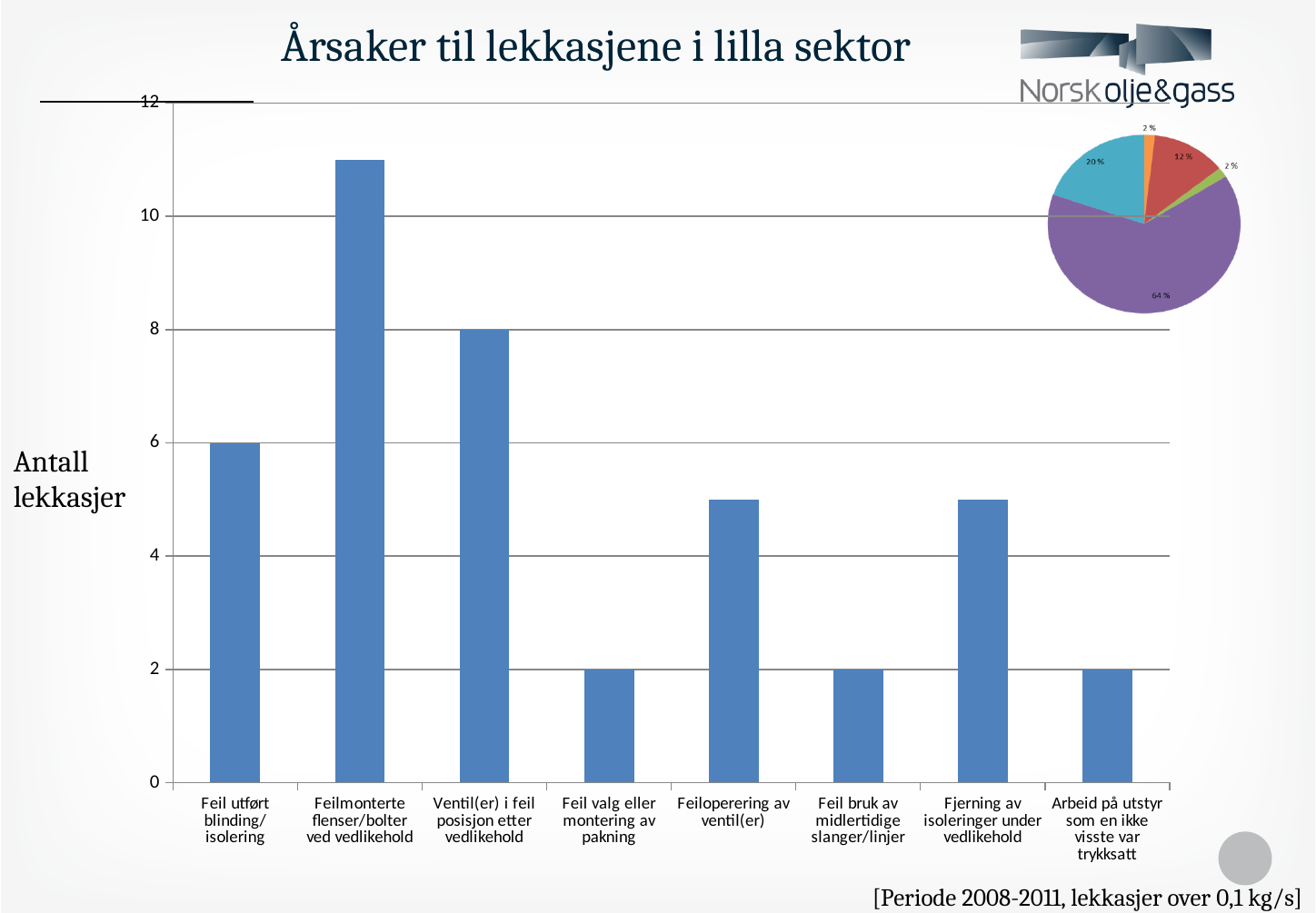
In the bar chart, is the value for 'Feiloperering av ventil(er)' greater or less than 4? greater In the bar chart, which is larger: 'Feil utført blinding/isolering' or 'Ventil(er) i feil posisjon etter vedlikehold'? Ventil(er) i feil posisjon etter vedlikehold What type of chart is the main chart on the slide? bar chart What is the title of the slide's chart? Årsaker til lekkasjene i lilla sektor In the bar chart, which category has the highest number of leaks? Feilmonterte flenser/bolter ved vedlikehold In the bar chart, what is the value for 'Feil valg eller montering av pakning'? 2 In the bar chart, what is the difference between 'Ventil(er) i feil posisjon etter vedlikehold' and 'Feil utført blinding/isolering'? 2 In the bar chart, what is the value for 'Ventil(er) i feil posisjon etter vedlikehold'? 8 In the bar chart, is the value for 'Feilmonterte flenser/bolter ved vedlikehold' greater or less than 10? greater In the bar chart, what is the value for 'Feil utført blinding/isolering'? 6 How many categories are shown on the x axis of the bar chart? 8 What is the label on the y axis of the bar chart? Antall lekkasjer